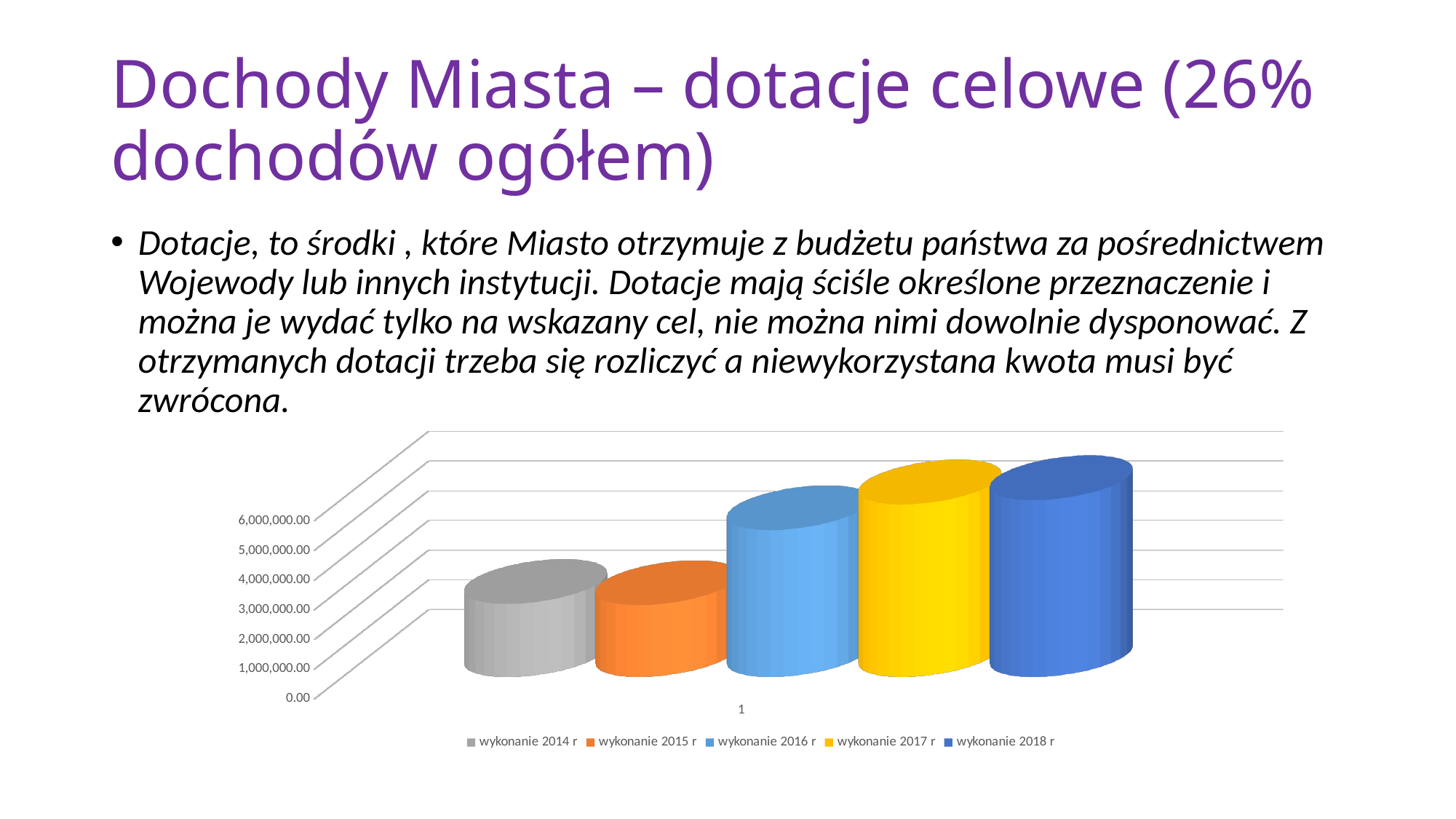
Which series is listed last in the chart legend? wykonanie 2018 r Which is larger, the value for wykonanie 2017 r or wykonanie 2015 r? wykonanie 2017 r What kind of chart is shown on the slide? bar chart Is the value for wykonanie 2018 r greater or less than 3,000,000.00? greater Is the value for wykonanie 2015 r greater or less than 1,000,000.00? greater Is the value for wykonanie 2014 r greater or less than 6,000,000.00? less How many series does the chart legend list? 5 Which is larger, the value for wykonanie 2018 r or wykonanie 2014 r? wykonanie 2018 r Which series is listed first in the chart legend? wykonanie 2014 r Which is larger, the value for wykonanie 2016 r or wykonanie 2015 r? wykonanie 2016 r How many categories are shown on the x axis of the chart? 1